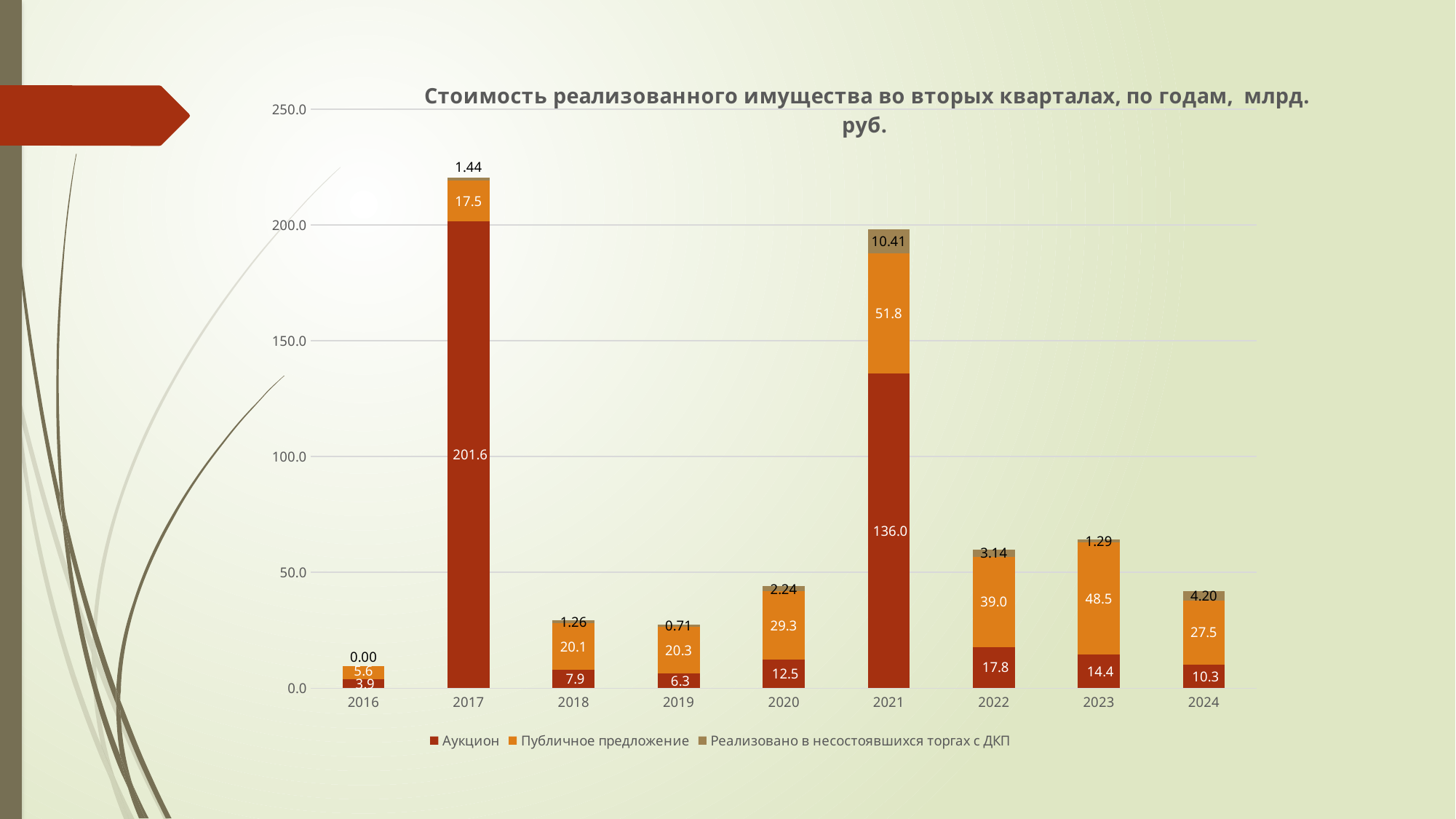
How many years are shown on the x axis? 9 What is the difference between the Аукцион values for 2017 and 2021? 65.6 Which year has the lowest value for Публичное предложение? 2016 Which is larger: Публичное предложение for 2022 or for 2023? 2023 What is the total of the stacked bar for 2021? 198.21 Is the total stacked bar for 2017 greater or less than 200.0? greater What is the value of Аукцион for 2017? 201.6 What is the value of Публичное предложение for 2021? 51.8 What is the value of Реализовано в несостоявшихся торгах с ДКП for 2024? 4.20 Which year has the highest value for Аукцион? 2017 What type of chart is shown on the slide? Stacked bar chart How many series does the legend list? 3